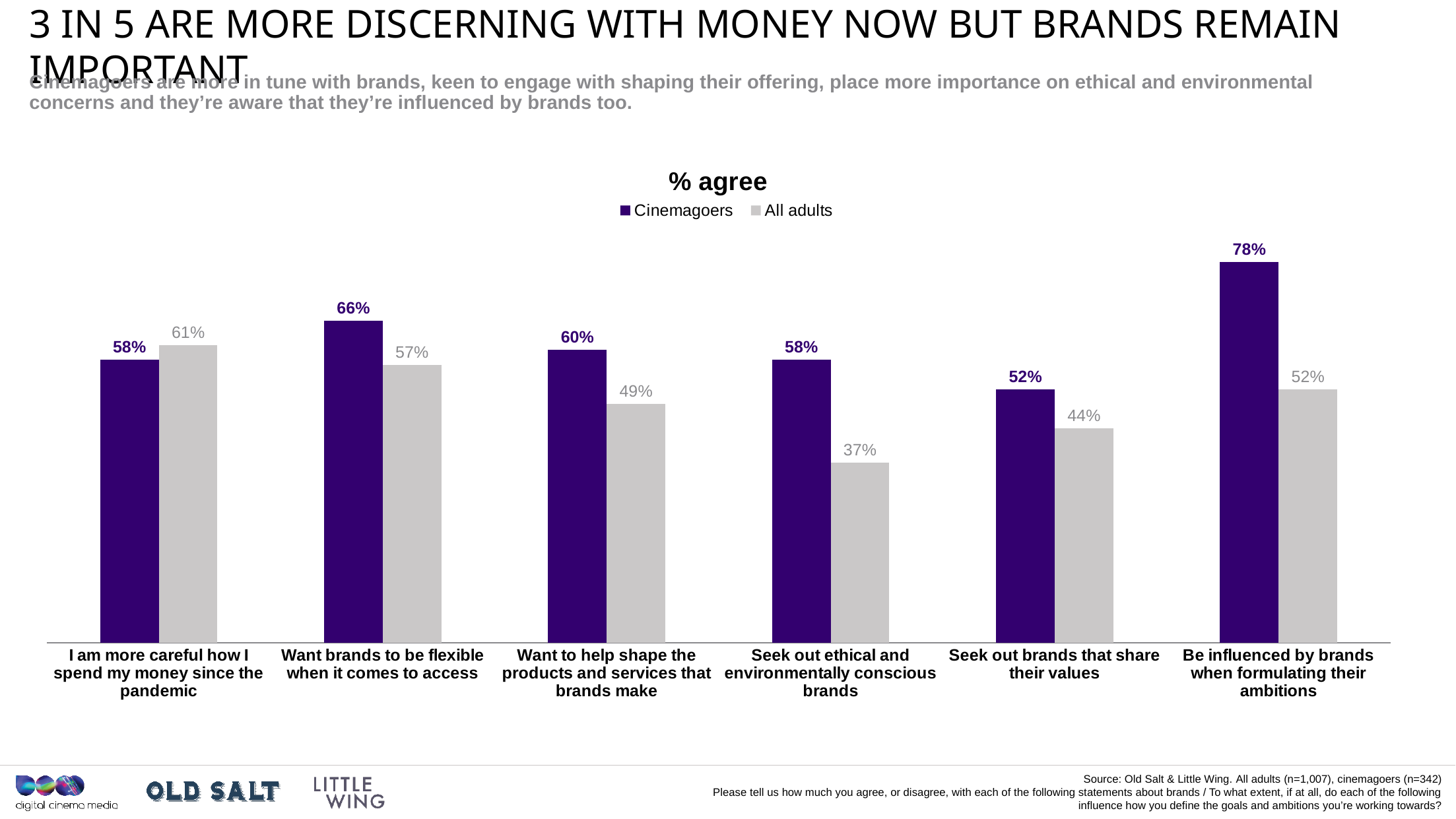
What is the difference between the Cinemagoers and All adults values for "Be influenced by brands when formulating their ambitions"? 26 percentage points What is the difference between the Cinemagoers and All adults values for "Seek out ethical and environmentally conscious brands"? 21 percentage points Which statement has the highest Cinemagoers value? Be influenced by brands when formulating their ambitions What is the title of the chart? % agree What is the Cinemagoers value for "Want brands to be flexible when it comes to access"? 66% What percentage of All adults agree with "Seek out ethical and environmentally conscious brands"? 37% For "I am more careful how I spend my money since the pandemic", which group has the higher value, Cinemagoers or All adults? All adults What kind of chart is shown on the slide? Bar chart What percentage of Cinemagoers agree with "Be influenced by brands when formulating their ambitions"? 78% How many series does the legend list? 2 How many statements are shown on the x axis of the chart? 6 Which statement has the lowest All adults value? Seek out ethical and environmentally conscious brands